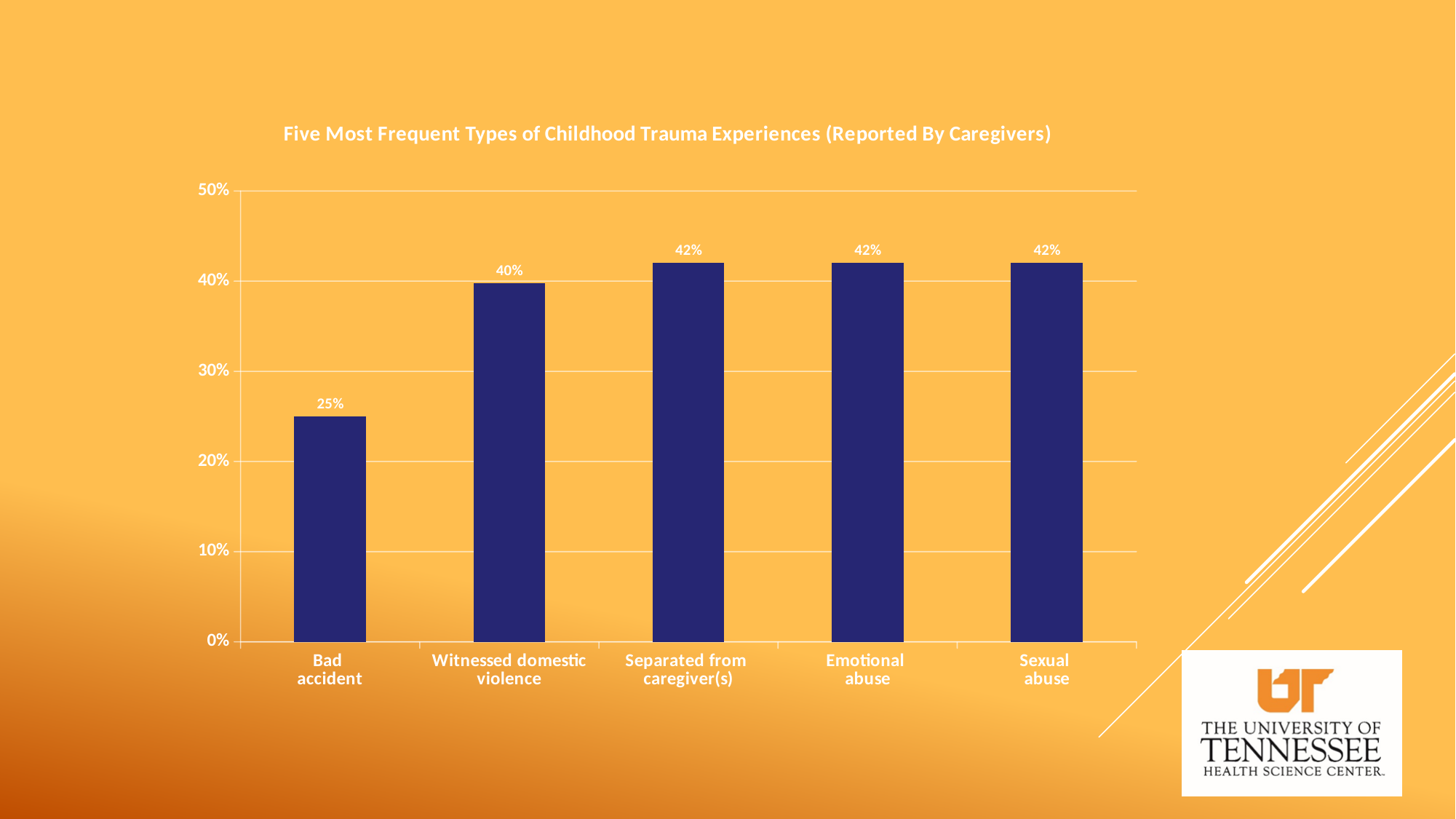
What is the difference between the values for Witnessed domestic violence and Bad accident? 15% What is the value for Emotional abuse? 42% What kind of chart is shown on the slide? bar chart Which category has the lowest value? Bad accident How many categories are shown on the chart? 5 What is the title of the chart? Five Most Frequent Types of Childhood Trauma Experiences (Reported By Caregivers) What is the value for Witnessed domestic violence? 40% What is the difference between the values for Separated from caregiver(s) and Bad accident? 17% What is the value for Sexual abuse? 42% Which is larger, the value for Bad accident or the value for Witnessed domestic violence? Witnessed domestic violence What is the value for Bad accident? 25% Is the value for Bad accident greater or less than 30%? less